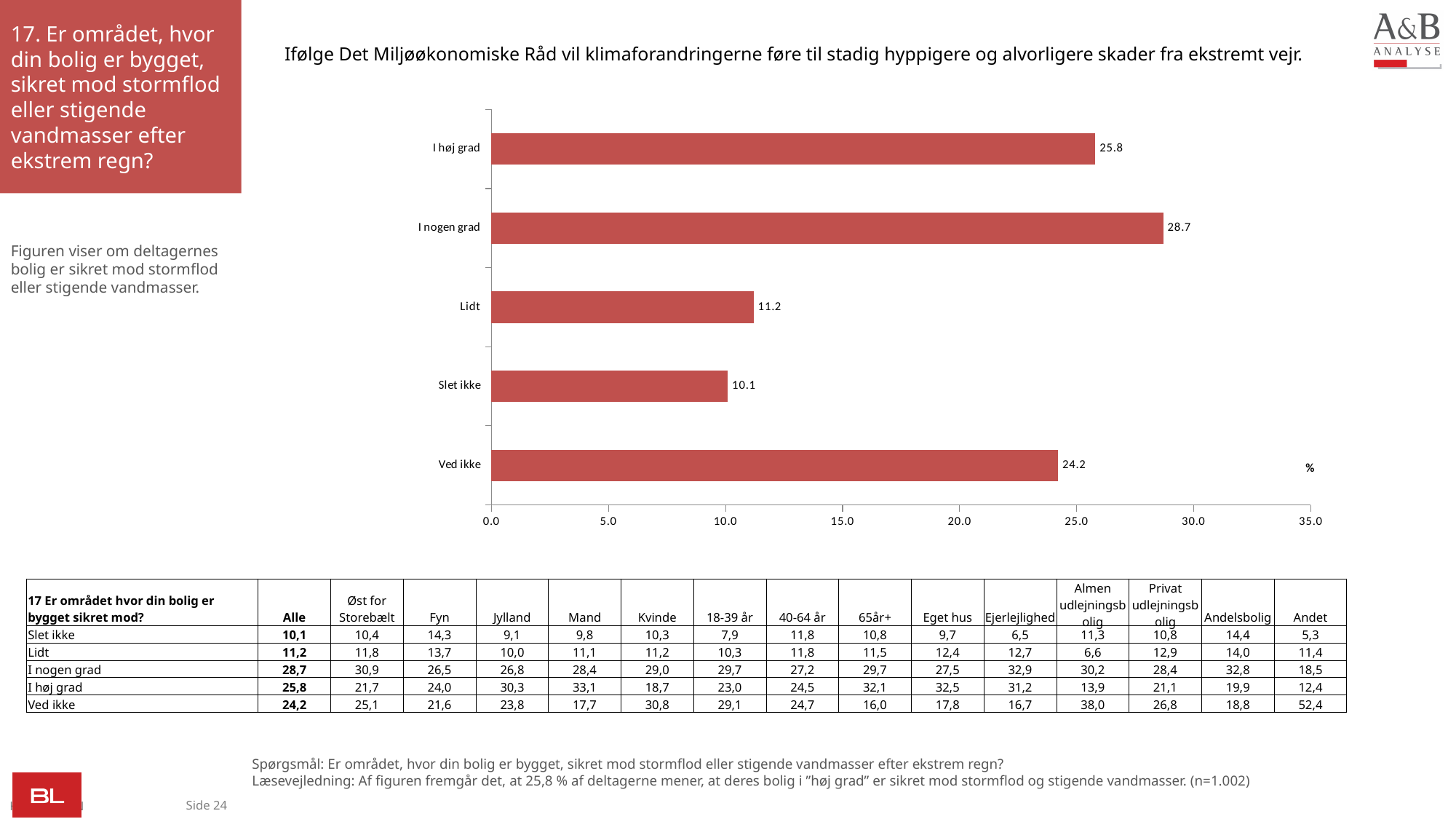
What is the value for "Slet ikke" in the bar chart? 10.1 What kind of chart is shown on the slide? Bar chart What is the difference between the values for "Lidt" and "Slet ikke"? 1.1 How many categories are shown in the bar chart? 5 Which category has the highest value in the bar chart? I nogen grad What is the value for "Ved ikke" in the bar chart? 24.2 What is the difference between the values for "I nogen grad" and "I høj grad"? 2.9 What is the value for "I høj grad" in the bar chart? 25.8 What is the maximum value shown on the x axis of the chart? 35.0 Which is larger, the value for "Ved ikke" or the value for "Lidt"? Ved ikke Which category has the lowest value in the bar chart? Slet ikke Is the value for "I nogen grad" greater or less than 25.0? greater